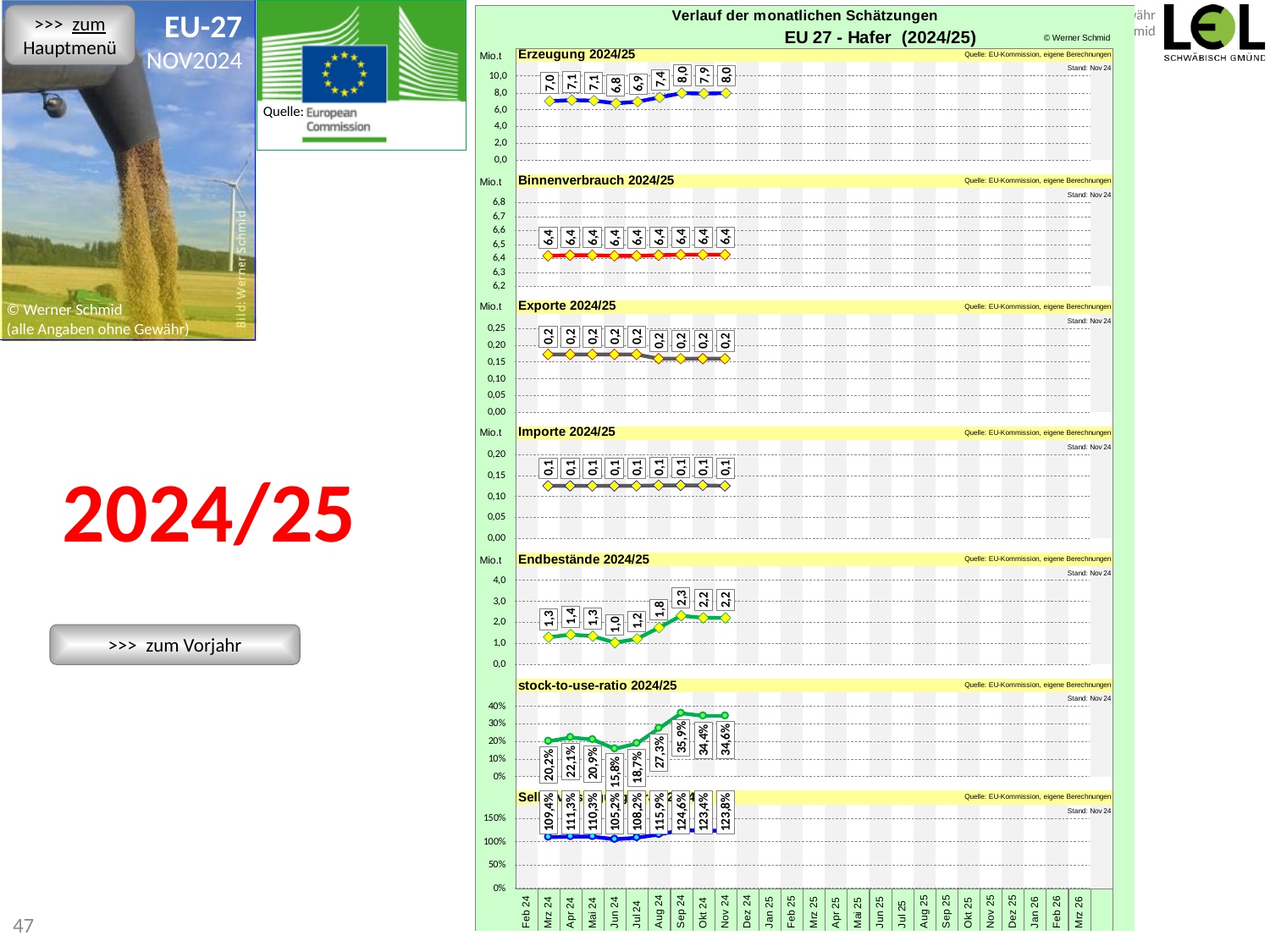
How many data points are plotted in the 'Importe 2024/25' chart? 9 What type of chart is the 'Erzeugung 2024/25' chart? line chart In the bottom chart (Selbstversorgungsgrad), what is the value for Sep 24? 124,6% In the 'Endbestände 2024/25' chart, what is the difference between the Sep 24 value and the Jun 24 value? 1,3 In the 'Erzeugung 2024/25' chart, what is the value for Nov 24? 8,0 In the 'Erzeugung 2024/25' chart, which month has the lowest value? Jun 24 In the 'Erzeugung 2024/25' chart, is the value for Aug 24 larger or smaller than the value for Jun 24? larger In the 'Binnenverbrauch 2024/25' chart, what is the value for Mrz 24? 6,4 In the 'stock-to-use-ratio 2024/25' chart, which month has the highest value? Sep 24 In the 'Endbestände 2024/25' chart, what is the value for Sep 24? 2,3 In the 'stock-to-use-ratio 2024/25' chart, what is the value for Jun 24? 15,8%